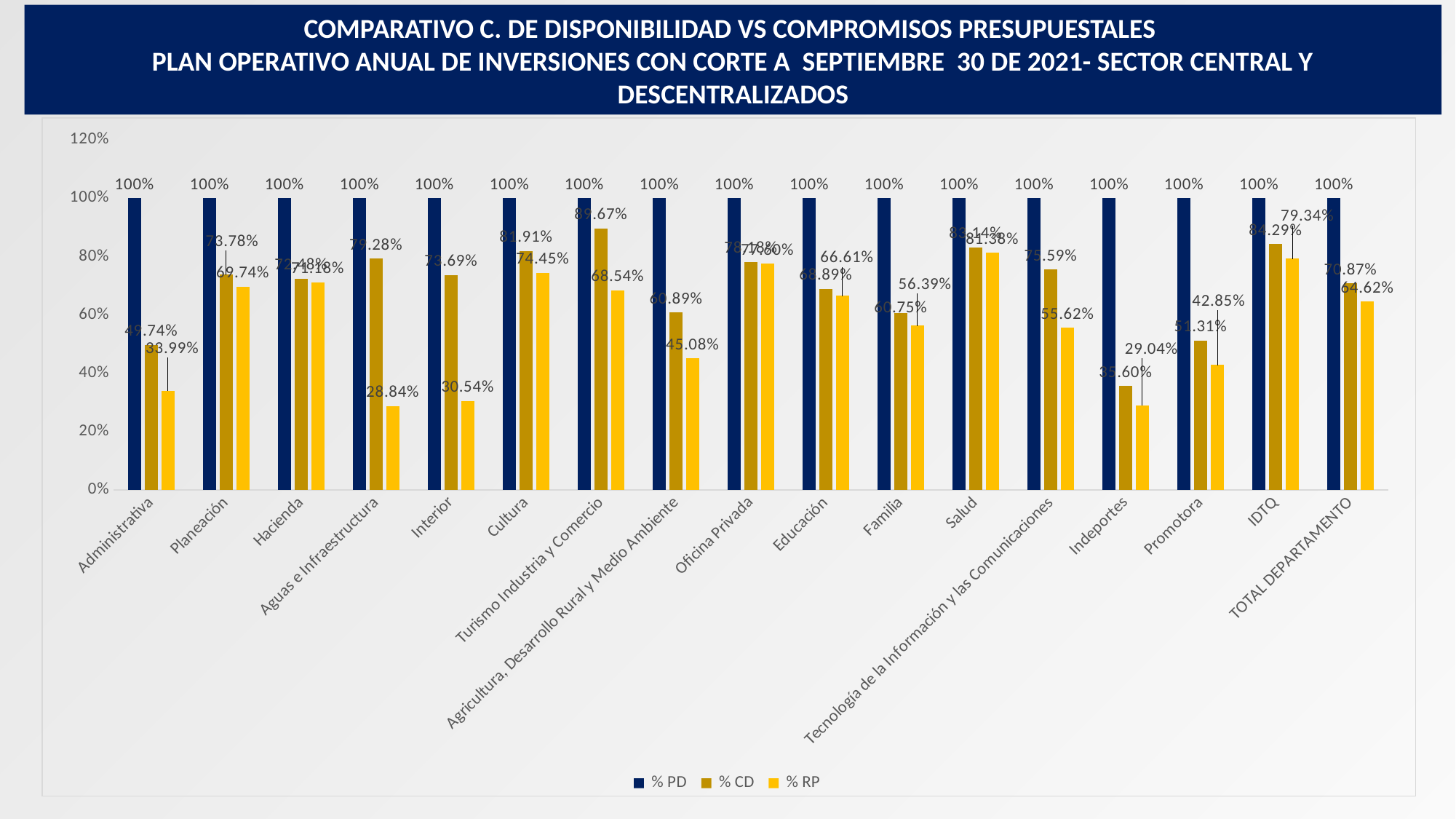
What is the % CD value for Turismo Industria y Comercio? 89.67% What kind of chart is shown on the slide? Bar chart Which category has the highest % CD value? Turismo Industria y Comercio What is the difference between the % CD and % RP values for Aguas e Infraestructura? 50.44% Which is larger for Familia, the % CD value or the % RP value? % CD Which category has the lowest % CD value? Indeportes How many series does the legend list? 3 What is the % RP value for IDTQ? 79.34% How many categories are shown on the x axis? 17 What is the % CD value for TOTAL DEPARTAMENTO? 70.87% What is the % RP value for Aguas e Infraestructura? 28.84% Is the % CD value for Hacienda greater or less than 60%? greater